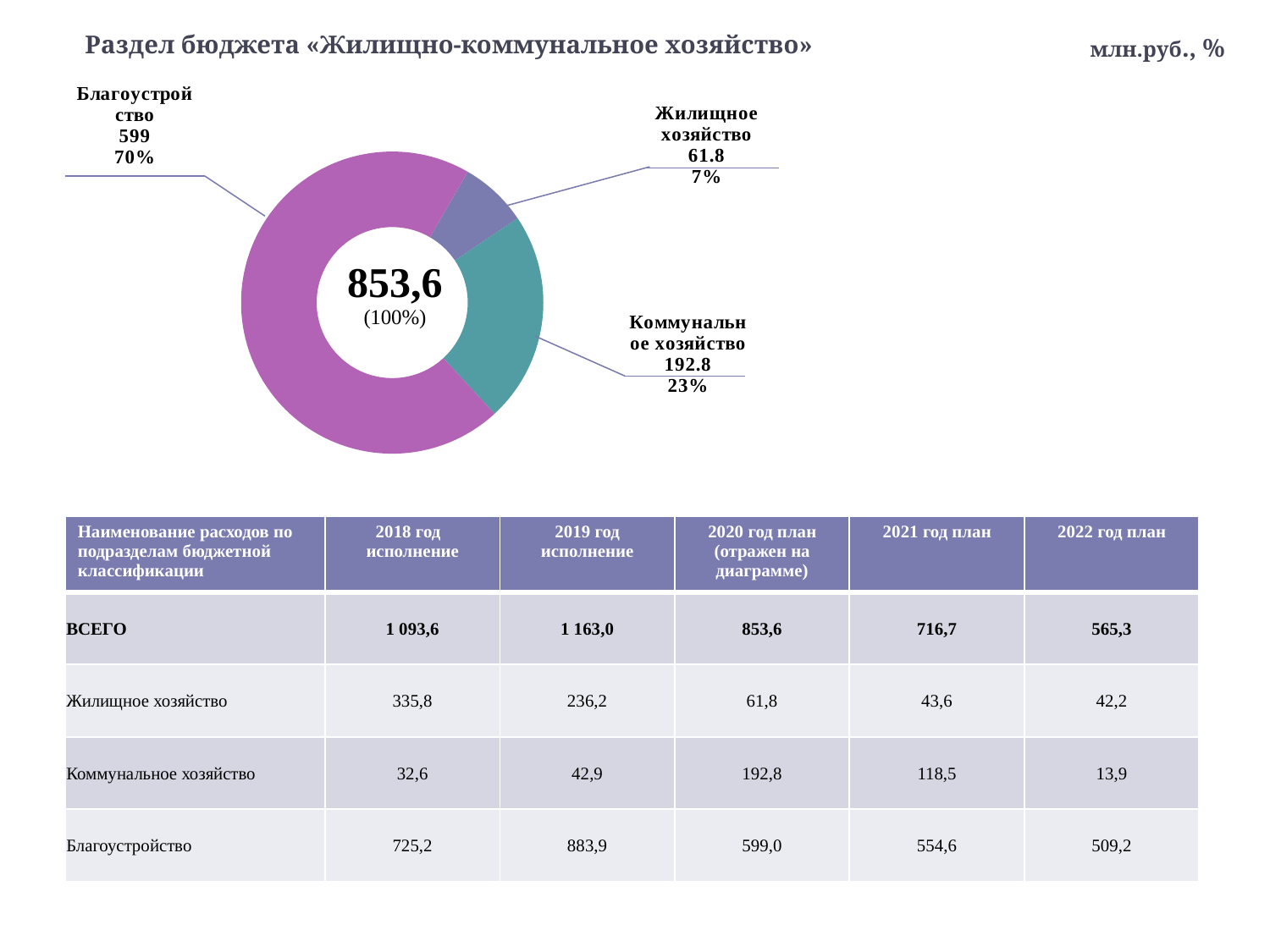
What is the value shown for Жилищное хозяйство on the chart? 61.8 What share of the chart does Благоустройство take? 70% How many categories are shown in the chart? 3 What kind of chart is shown on the slide? Pie (donut) chart Which category has the largest slice in the chart? Благоустройство What share of the chart does Коммунальное хозяйство take? 23% What is the value shown for Благоустройство on the chart? 599 What share of the chart does Жилищное хозяйство take? 7% What is the value shown for Коммунальное хозяйство on the chart? 192.8 Which category has the smallest slice in the chart? Жилищное хозяйство What total value is shown in the centre of the chart? 853,6 Which is larger in the chart, Коммунальное хозяйство or Жилищное хозяйство? Коммунальное хозяйство